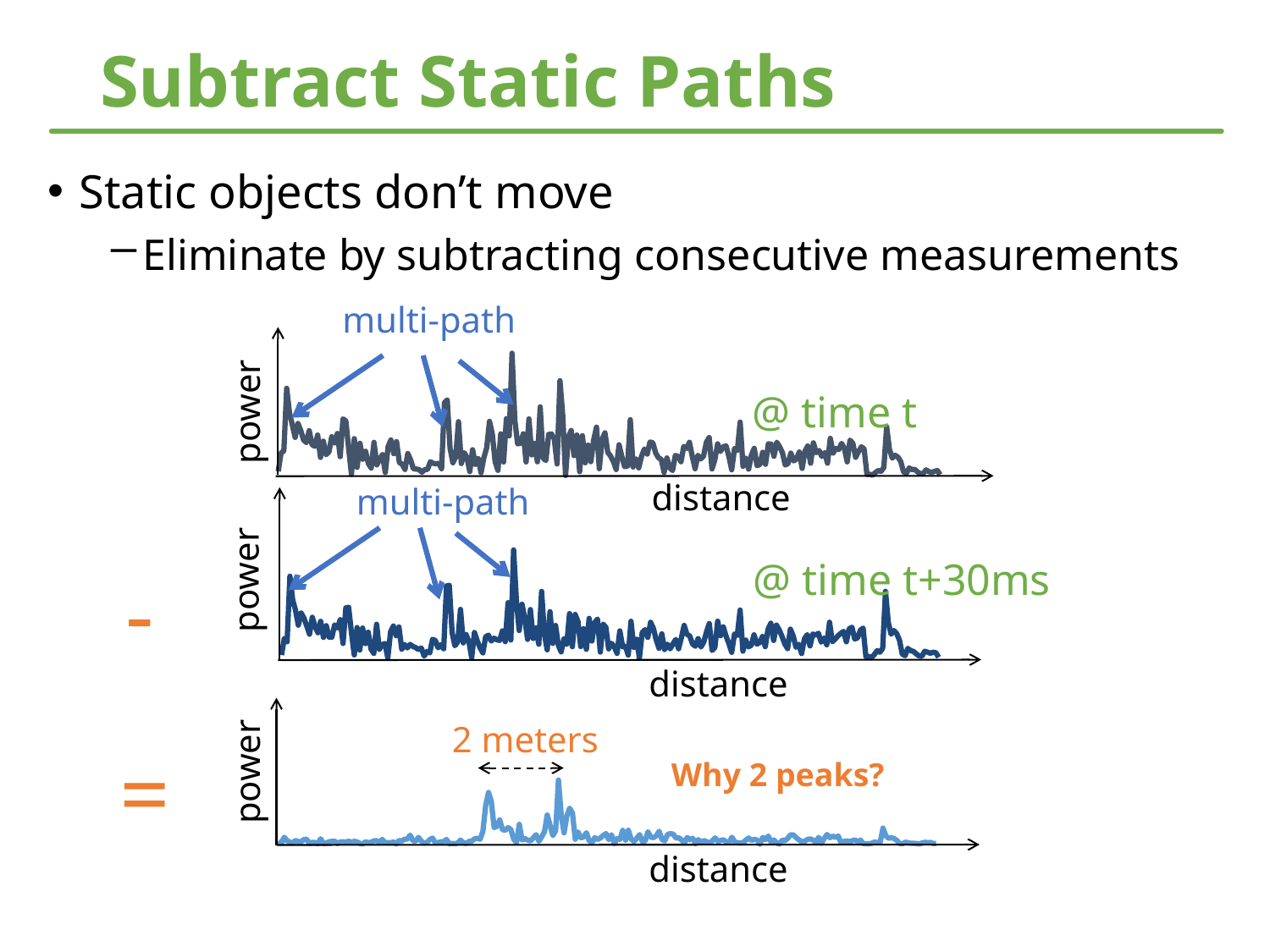
What is the x-axis label on the charts? distance How many prominent peaks remain in the bottom chart after subtraction? 2 In the middle chart, how many peaks are marked with 'multi-path' arrows? 3 What kind of chart is the top chart labelled '@ time t'? line chart In the bottom chart, what distance is printed between the two peaks? 2 meters What time label is printed on the middle chart? @ time t+30ms How many charts are shown on the slide? 3 What kind of chart is the bottom chart (the result after the '=' sign)? line chart